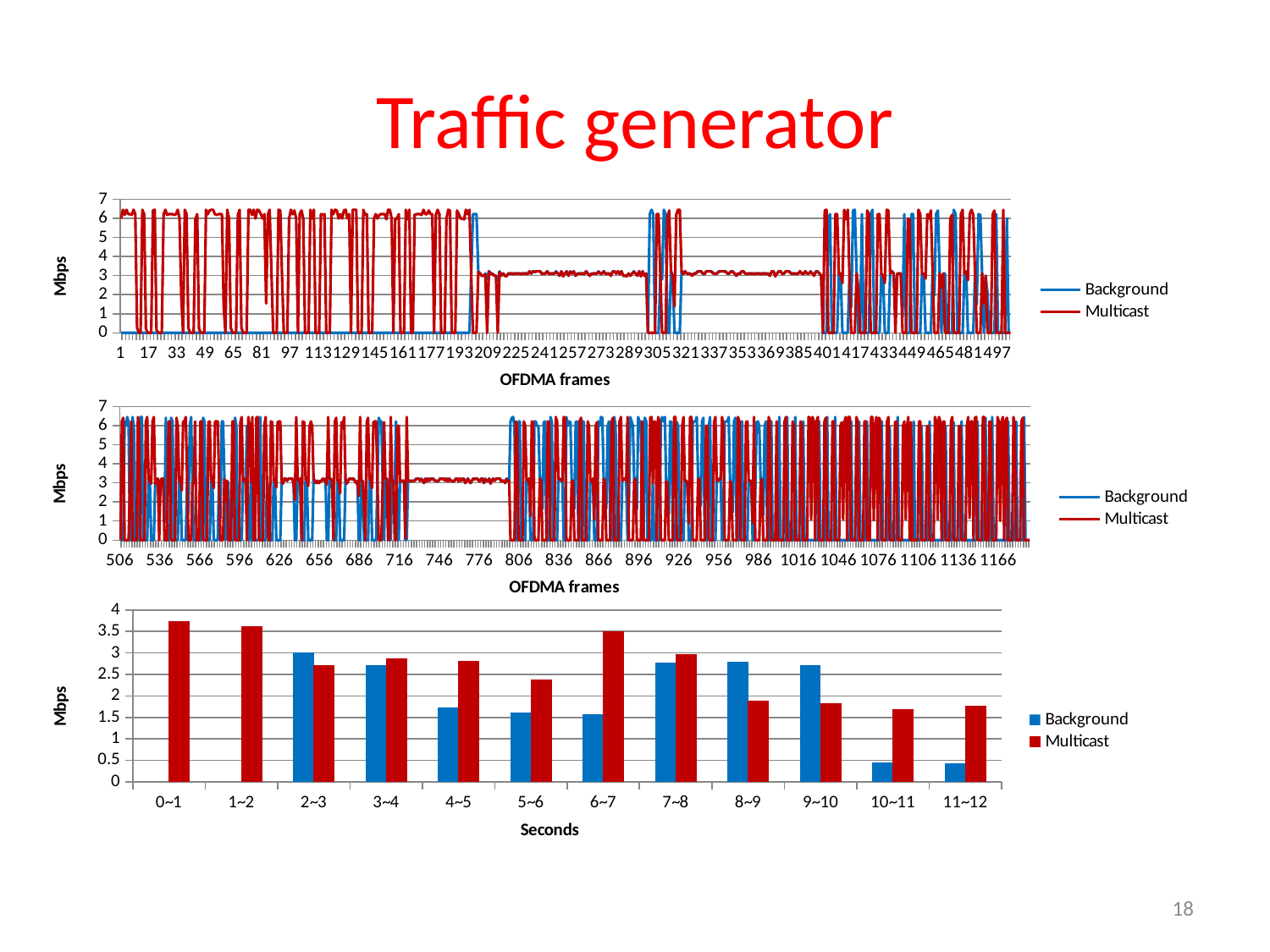
What kind of chart is the top chart on the slide? line chart In the bottom bar chart, is the Background value for 4~5 greater or less than 2? less In the bottom bar chart, which is larger for 6~7, Background or Multicast? Multicast How many series does the legend of the bottom bar chart list? 2 What is the x-axis title of the top line chart? OFDMA frames In the bottom bar chart, is the Multicast value for 0~1 greater or less than 3.5? greater In the bottom bar chart, is the Multicast value for 5~6 greater or less than 2? greater What is the x-axis title of the bottom bar chart? Seconds In the bottom bar chart, which is larger for 9~10, Background or Multicast? Background How many categories are shown on the x axis of the bottom bar chart? 12 What kind of chart is the bottom chart on the slide? bar chart